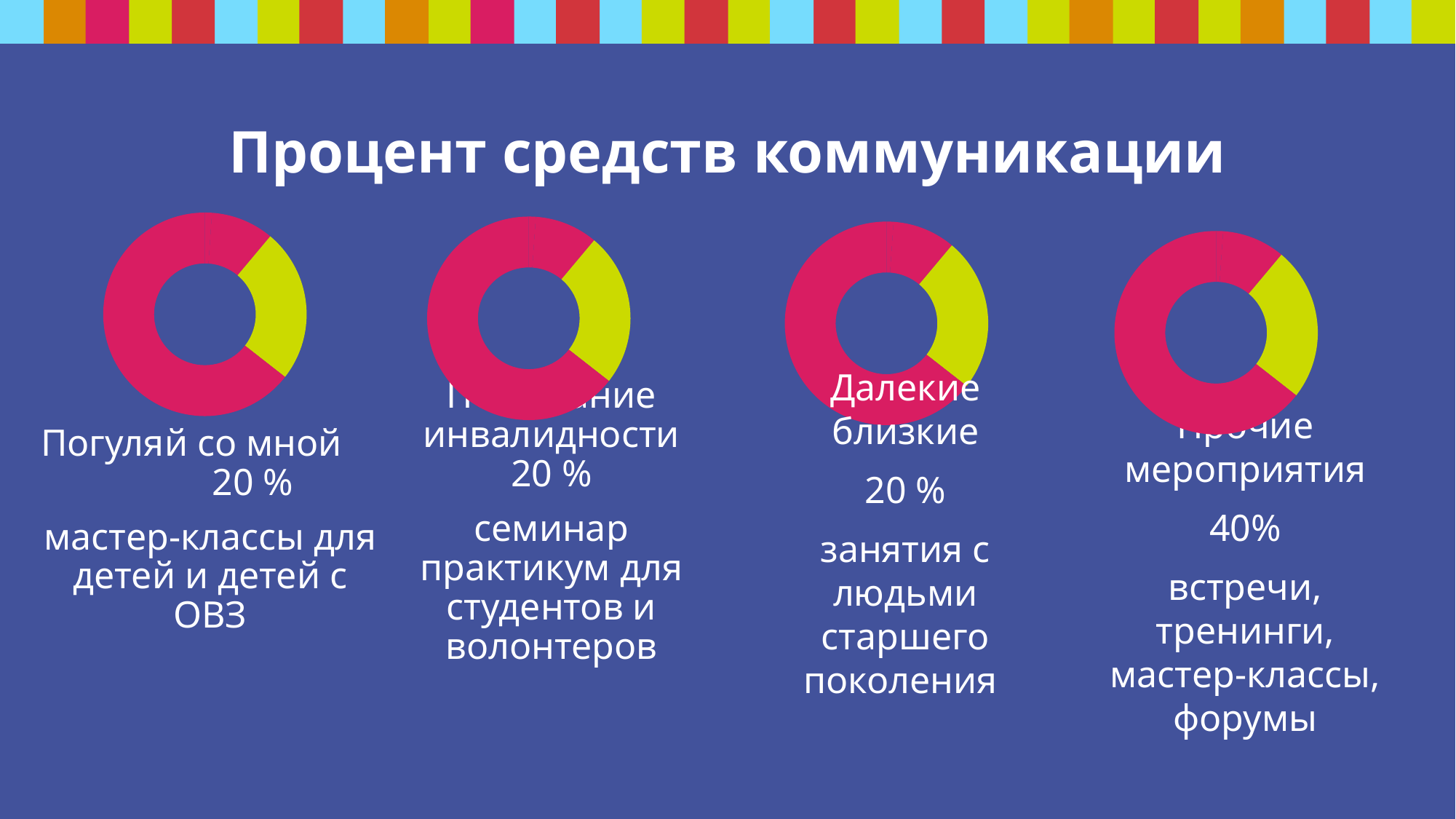
What kind of chart is used for each of the four figures on the slide? Donut (pie) chart What two colours are used for the slices in the donut charts? Pink and yellow-green Which of the four charts has the highest percentage? Прочие мероприятия (40%) Which is larger: the percentage for "Прочие мероприятия" or for "Погуляй со мной"? Прочие мероприятия What percentage is shown for the second chart from the left, "...ание инвалидности"? 20 % What percentage is shown for the leftmost chart, "Погуляй со мной"? 20 % How many slices does each donut chart contain? 4 How many donut charts are shown on the slide? 4 What is the difference between the percentage for "Прочие мероприятия" and the percentage for "Далекие близкие"? 20 percentage points What percentage is shown for the third chart from the left, "Далекие близкие"? 20 % What is the slide title above the charts? Процент средств коммуникации What percentage is shown for the rightmost chart, "Прочие мероприятия"? 40%